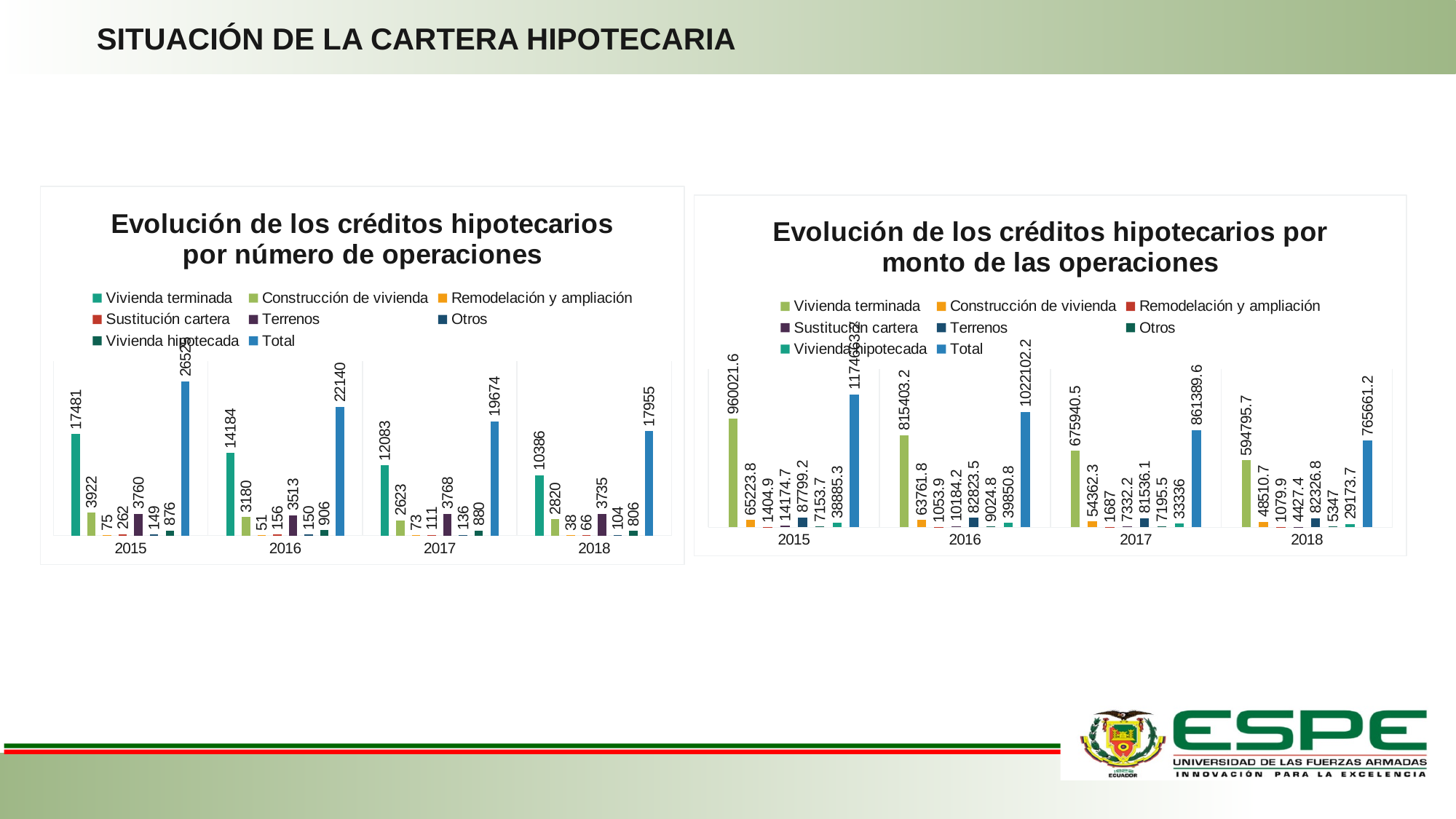
In the chart 'Evolución de los créditos hipotecarios por número de operaciones', what is the value of Terrenos in 2017? 3768 In the chart 'Evolución de los créditos hipotecarios por número de operaciones', does the Total rise or fall from 2016 to 2018? Fall How many series does the legend of the chart 'Evolución de los créditos hipotecarios por número de operaciones' list? 8 In the chart 'Evolución de los créditos hipotecarios por número de operaciones', what is the difference between the Total for 2016 and the Total for 2017? 2466 In the chart 'Evolución de los créditos hipotecarios por monto de las operaciones', what is the Total for 2017? 861389.6 In the chart 'Evolución de los créditos hipotecarios por número de operaciones', which year has the lowest value for Vivienda terminada? 2018 What kind of chart is 'Evolución de los créditos hipotecarios por monto de las operaciones'? Bar chart In the chart 'Evolución de los créditos hipotecarios por número de operaciones', what is the value of Vivienda terminada in 2015? 17481 In the chart 'Evolución de los créditos hipotecarios por número de operaciones', what is the Total for 2018? 17955 In the chart 'Evolución de los créditos hipotecarios por monto de las operaciones', what is the value of Vivienda terminada in 2016? 815403.2 How many years are shown on the x axis of the chart 'Evolución de los créditos hipotecarios por monto de las operaciones'? 4 In the chart 'Evolución de los créditos hipotecarios por monto de las operaciones', which is larger: Terrenos in 2016 or Terrenos in 2018? Terrenos in 2016